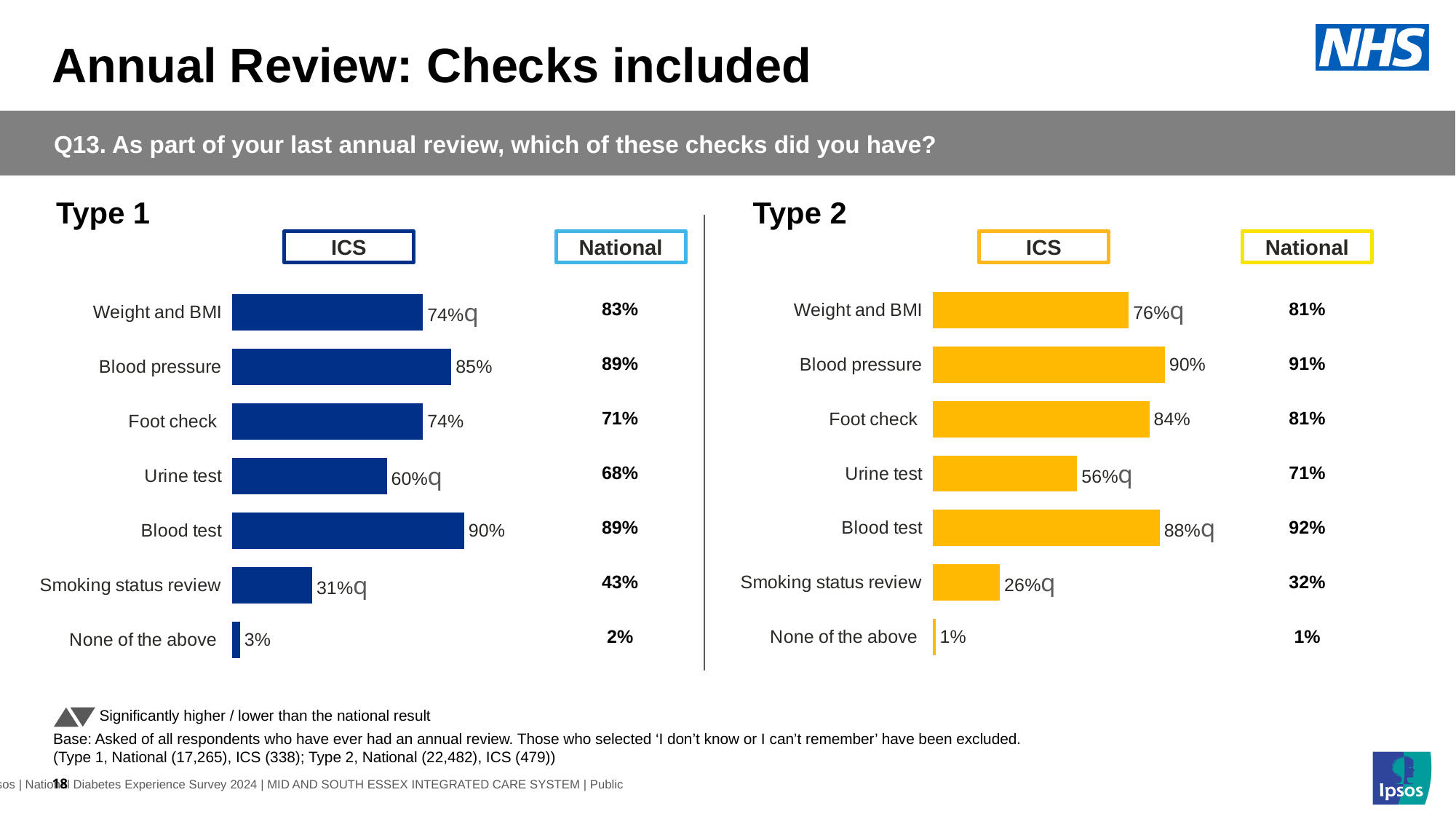
What kind of chart is used for the Type 2 ICS results? Bar chart In the Type 1 chart, which check has the highest ICS value? Blood test In the Type 2 chart, what is the National value for Blood test? 92% In the Type 1 chart, what is the National value for Smoking status review? 43% In the Type 2 chart, what is the difference between the ICS and National values for Smoking status review? 6 percentage points In the Type 2 chart, what is the ICS value for Urine test? 56% What colour are the ICS bars in the Type 2 chart? Yellow In the Type 1 chart, what is the difference between the National and ICS values for Weight and BMI? 9 percentage points In the Type 2 chart, which is larger, the ICS value for Foot check or the ICS value for Weight and BMI? Foot check How many checks are listed in the Type 1 chart? 7 In the Type 1 chart, what is the ICS value for Blood pressure? 85% In the Type 2 chart, which check has the lowest ICS value? None of the above